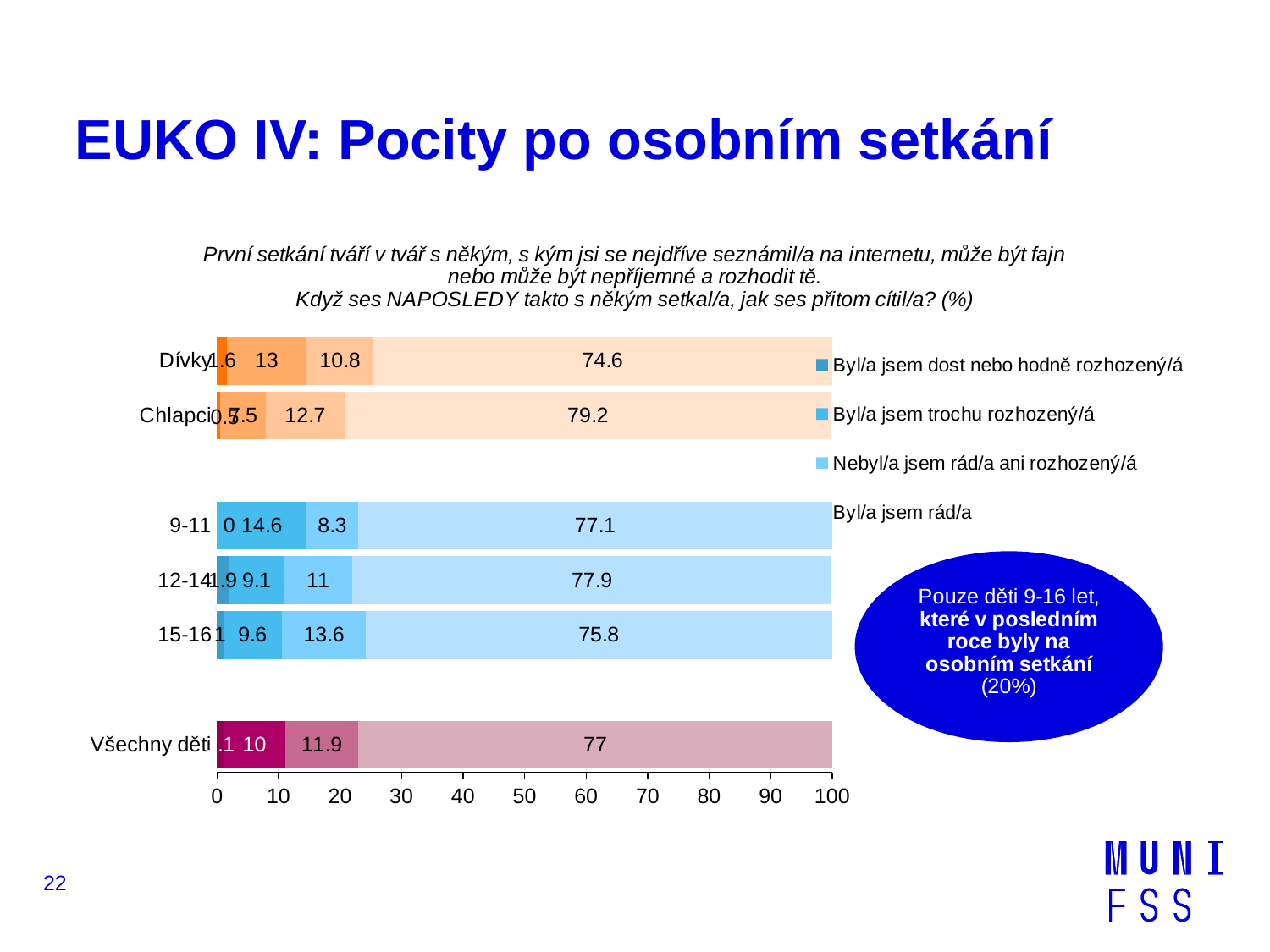
Which category has the lowest value for "Byl/a jsem rád/a"? Dívky Which age group has the larger value for "Nebyl/a jsem rád/a ani rozhozený/á": 15-16 or 9-11? 15-16 What is the value of "Nebyl/a jsem rád/a ani rozhozený/á" for the 12-14 age group? 11 What is the value of "Byl/a jsem trochu rozhozený/á" for the 9-11 age group? 14.6 What is the value of "Byl/a jsem rád/a" for Všechny děti? 77 How many series does the legend list? 4 How many categories (bars) are plotted in the chart? 6 What is the value of "Byl/a jsem rád/a" for Dívky? 74.6 What is the value of "Byl/a jsem rád/a" for Chlapci? 79.2 Which category has the highest value for "Byl/a jsem rád/a"? Chlapci What kind of chart is shown on the slide? bar chart What is the difference between the "Byl/a jsem rád/a" values for Chlapci and Dívky? 4.6